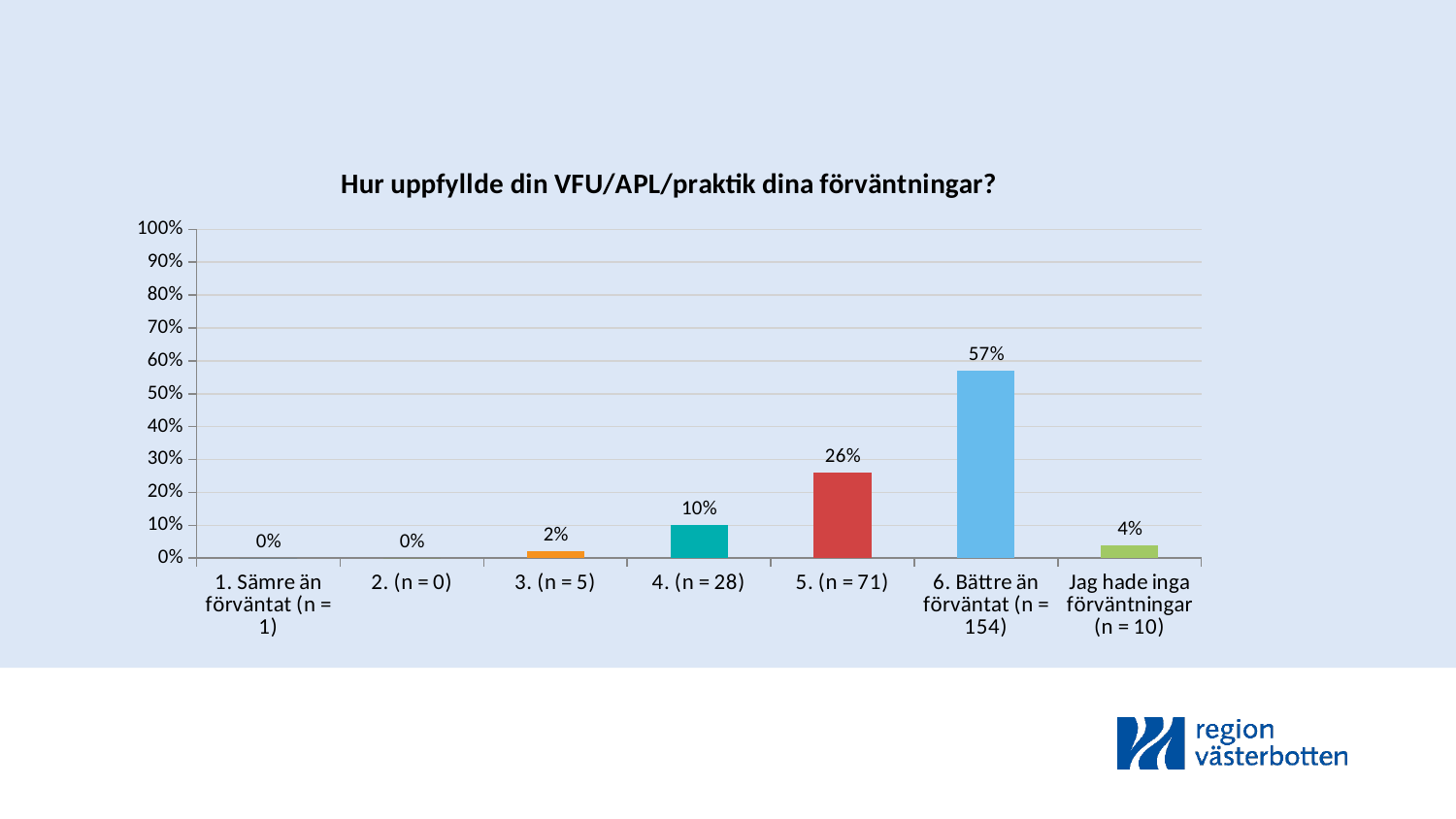
Which is larger, the value for "4. (n = 28)" or the value for "Jag hade inga förväntningar (n = 10)"? 4. (n = 28) What is the value for the category "3. (n = 5)"? 2% What is the title of the chart? Hur uppfyllde din VFU/APL/praktik dina förväntningar? What is the value for the category "4. (n = 28)"? 10% How many categories are shown on the x axis? 7 What is the value for the category "Jag hade inga förväntningar (n = 10)"? 4% Is the value for "6. Bättre än förväntat (n = 154)" greater or less than 50%? greater What is the value for the category "6. Bättre än förväntat (n = 154)"? 57% What kind of chart is shown on the slide? bar chart Which category has the highest value? 6. Bättre än förväntat (n = 154) What is the difference between the values for "6. Bättre än förväntat (n = 154)" and "5. (n = 71)"? 31% What is the value for the category "5. (n = 71)"? 26%